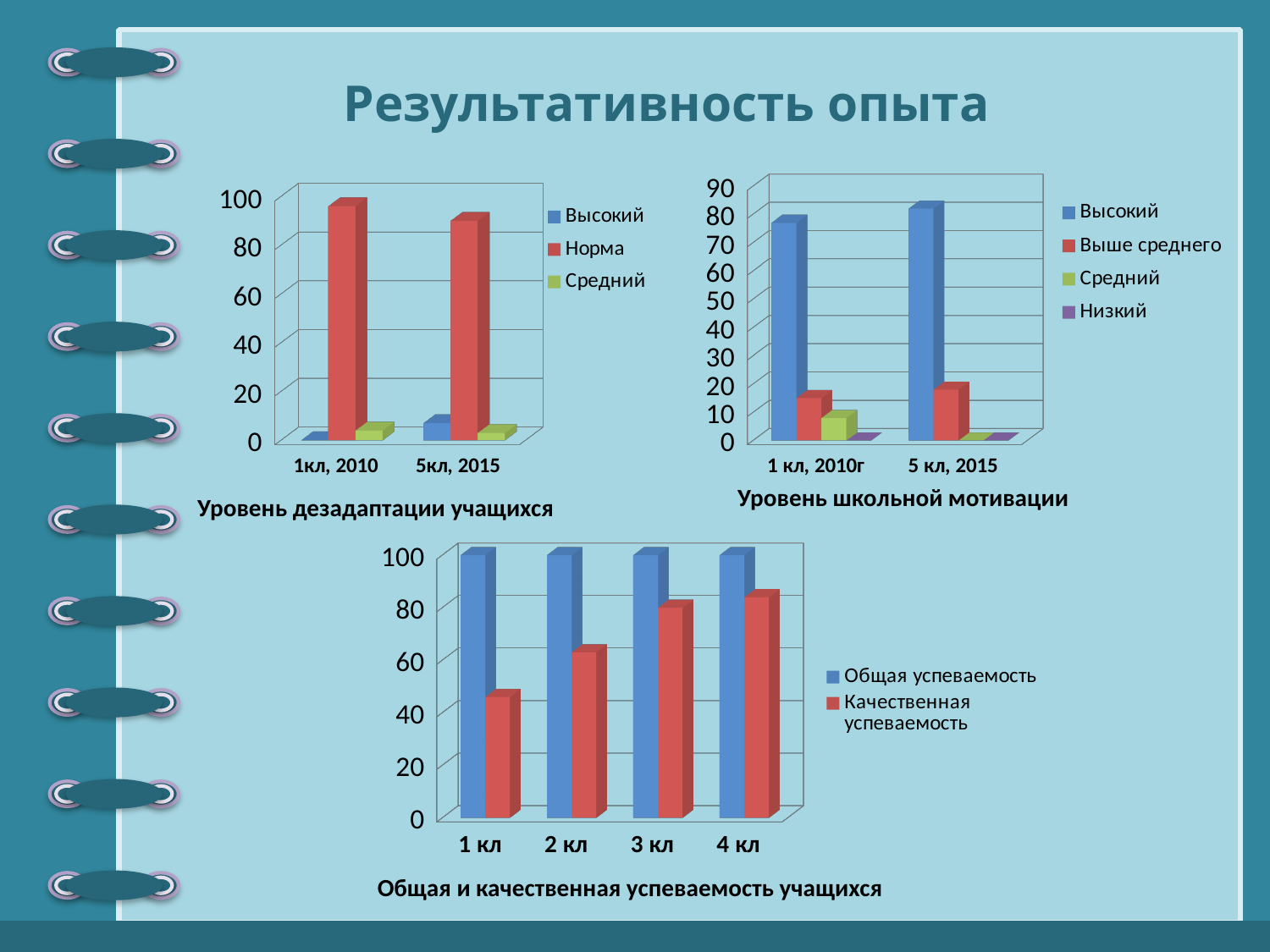
What kind of chart is 'Общая и качественная успеваемость учащихся'? bar chart In 'Общая и качественная успеваемость учащихся', is the value of 'Качественная успеваемость' for '2 кл' greater or less than 80? less How many categories are shown on the x axis of 'Общая и качественная успеваемость учащихся'? 4 In 'Уровень школьной мотивации', is the value of 'Высокий' for '5 кл, 2015' greater or less than 70? greater How many series does the legend of 'Уровень дезадаптации учащихся' list? 3 In 'Общая и качественная успеваемость учащихся', which category has the lowest 'Качественная успеваемость'? 1 кл How many series does the legend of 'Уровень школьной мотивации' list? 4 In 'Уровень дезадаптации учащихся', is the value of 'Норма' for '5кл, 2015' greater or less than 80? greater In 'Уровень школьной мотивации', which is larger for '1 кл, 2010г': 'Высокий' or 'Выше среднего'? Высокий In 'Общая и качественная успеваемость учащихся', does 'Качественная успеваемость' rise or fall from '1 кл' to '4 кл'? rise In 'Уровень дезадаптации учащихся', which series has the highest value for '1кл, 2010'? Норма In 'Общая и качественная успеваемость учащихся', what is the value of 'Общая успеваемость' for '1 кл'? 100